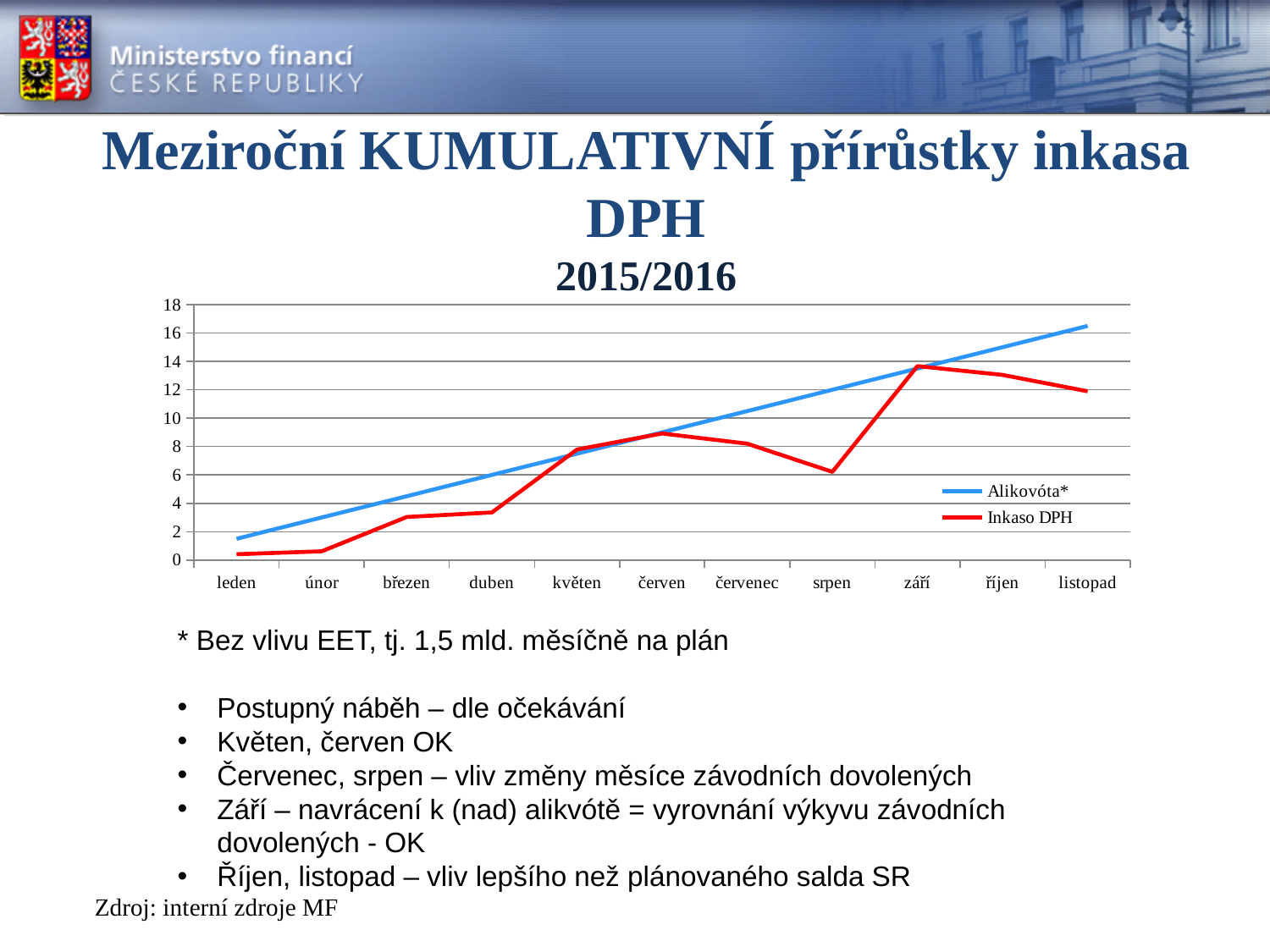
In listopad, which series has the higher value, Alikovóta* or Inkaso DPH? Alikovóta* Is the Inkaso DPH value for srpen greater or less than 8? less What kind of chart is shown on the slide? line chart Is the Inkaso DPH value for květen greater or less than 6? greater Is the Inkaso DPH value for leden greater or less than 2? less How many series does the chart legend list? 2 Does the Alikovóta* line rise or fall from leden to listopad? rise How many months are shown on the x axis of the chart? 11 What colour is the Inkaso DPH line in the chart? red In srpen, which series has the higher value, Alikovóta* or Inkaso DPH? Alikovóta* In which month does the Inkaso DPH line reach its highest value? září